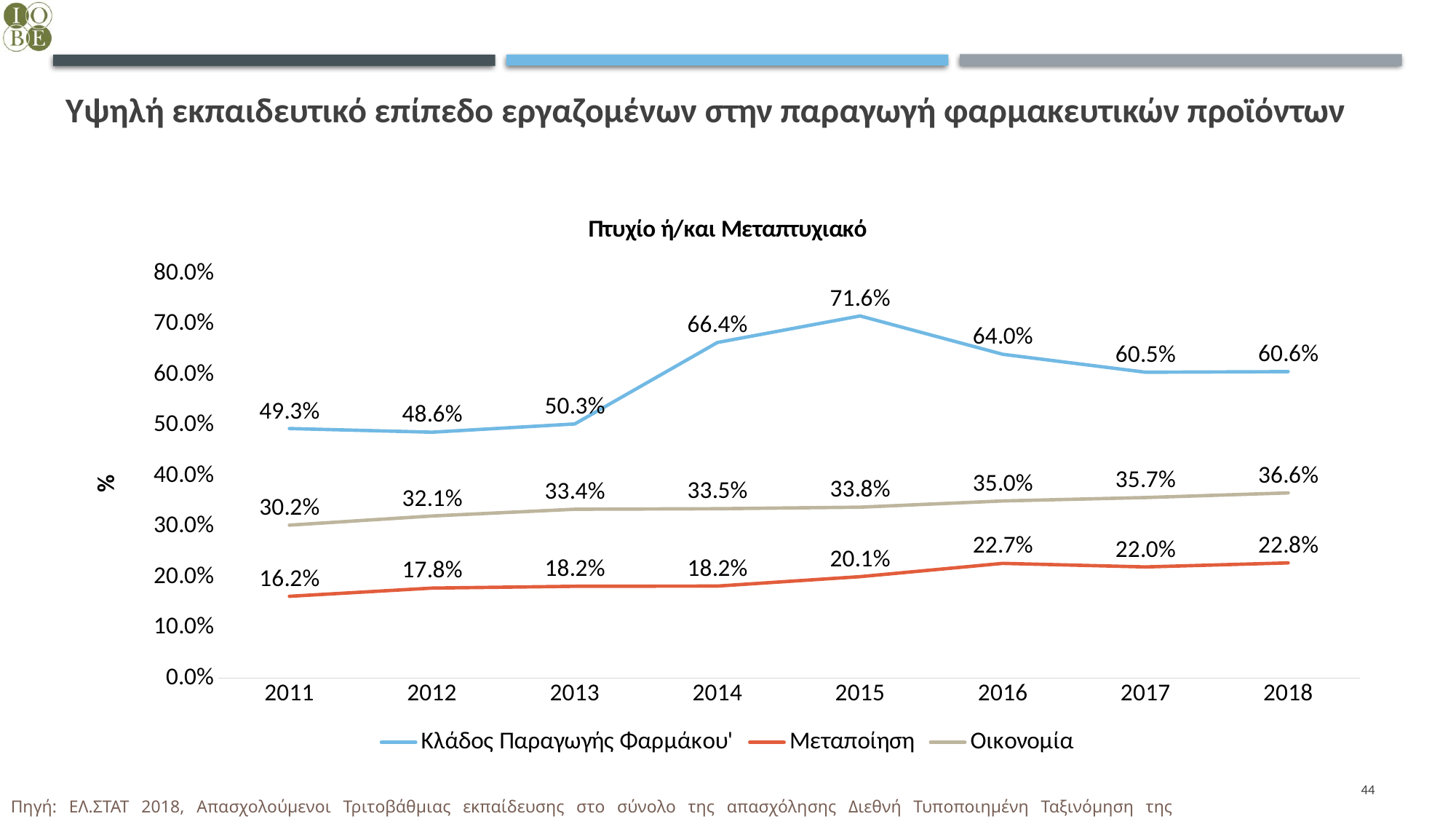
Does the value for Οικονομία rise or fall from 2011 to 2018? rise What is the difference between Κλάδος Παραγωγής Φαρμάκου and Οικονομία in 2018? 24.0% In which year is the value for Μεταποίηση lowest? 2011 What is the value for Οικονομία in 2018? 36.6% What is the value for Κλάδος Παραγωγής Φαρμάκου in 2015? 71.6% What is the value for Μεταποίηση in 2011? 16.2% How many years are shown on the x axis? 8 How many series does the legend list? 3 In which year does Κλάδος Παραγωγής Φαρμάκου reach its highest value? 2015 What type of chart is shown on the slide? line chart Which is larger in 2016: Οικονομία or Μεταποίηση? Οικονομία What is the title of the chart? Πτυχίο ή/και Μεταπτυχιακό